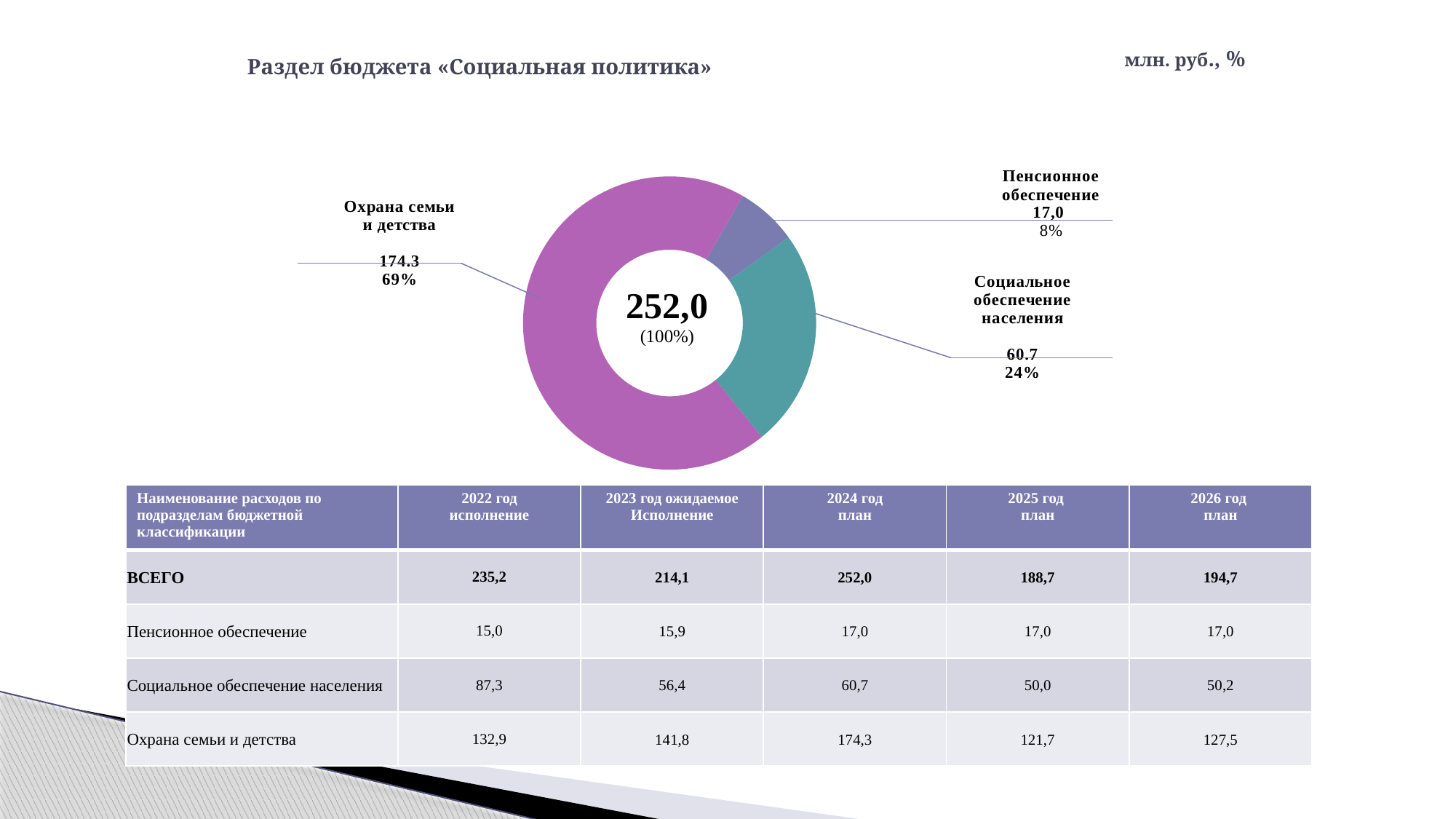
Which category has the smallest slice in the donut chart? Пенсионное обеспечение What share of the donut chart does Пенсионное обеспечение take? 8% What is the value for Социальное обеспечение населения in the donut chart? 60.7 What share of the donut chart does Социальное обеспечение населения take? 24% What is the value for Охрана семьи и детства in the donut chart? 174.3 Which category has the largest slice in the donut chart? Охрана семьи и детства What is the value for Пенсионное обеспечение in the donut chart? 17,0 How many slices does the donut chart have? 3 What share of the donut chart does Охрана семьи и детства take? 69% What kind of chart is shown on the slide? Donut (pie) chart What total value is shown in the centre of the donut chart? 252,0 Which is larger in the donut chart: Социальное обеспечение населения or Пенсионное обеспечение? Социальное обеспечение населения